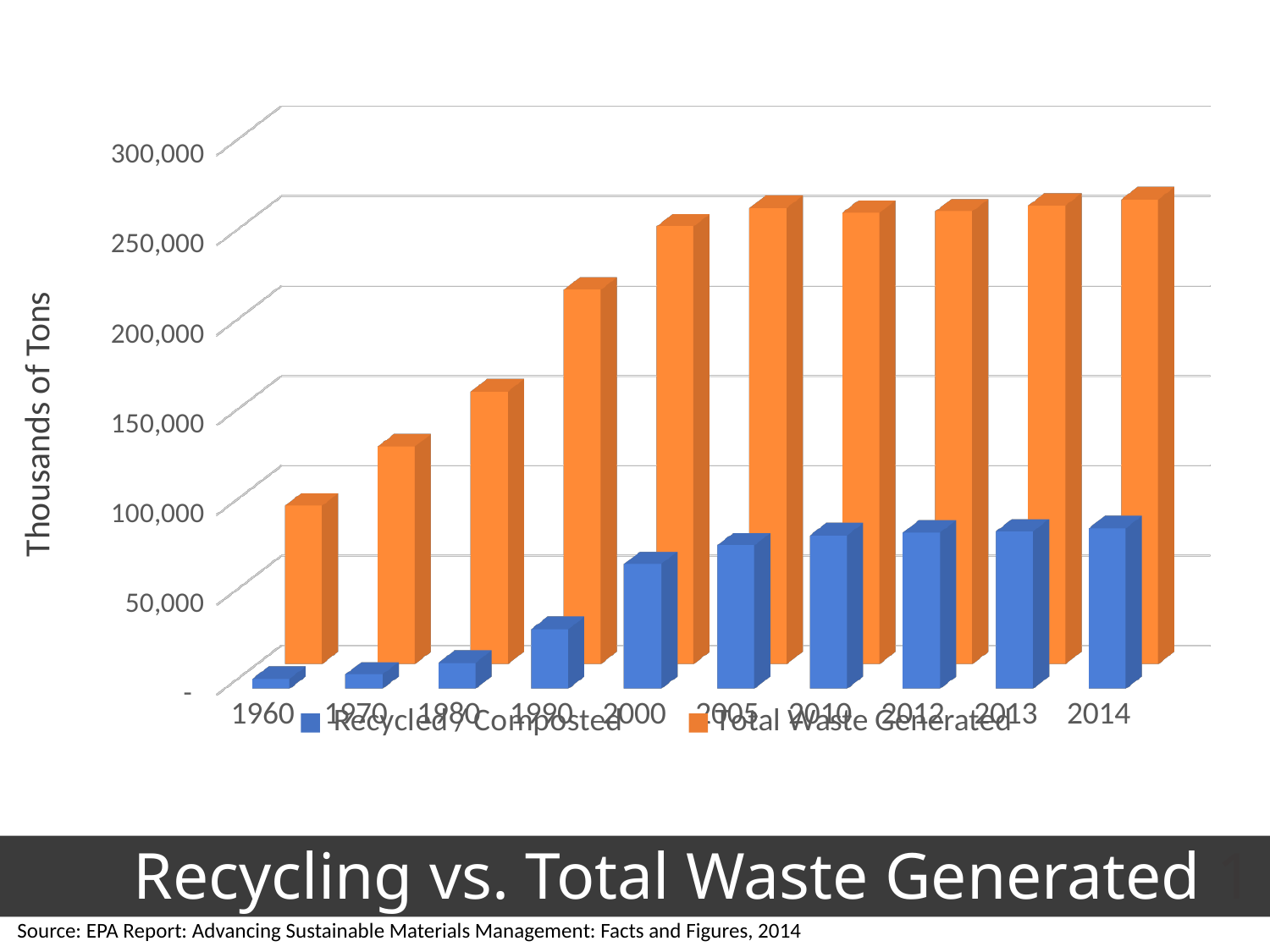
Which series is shown in orange in the chart? Total Waste Generated What is the label on the vertical axis of the chart? Thousands of Tons Does Total Waste Generated generally rise or fall from 1960 to 2014? rise Is the Total Waste Generated value for 1980 greater or less than 100,000? greater Which is larger: Recycled / Composted in 2005 or Recycled / Composted in 1980? 2005 What kind of chart is shown on the slide? bar chart Which year has the lowest Total Waste Generated? 1960 Is the Recycled / Composted value for 1990 greater or less than 50,000? less Which year has the lowest Recycled / Composted value? 1960 How many series does the chart's legend list? 2 How many years are shown along the x axis of the chart? 10 Is the Total Waste Generated value for 2000 greater or less than 200,000? greater